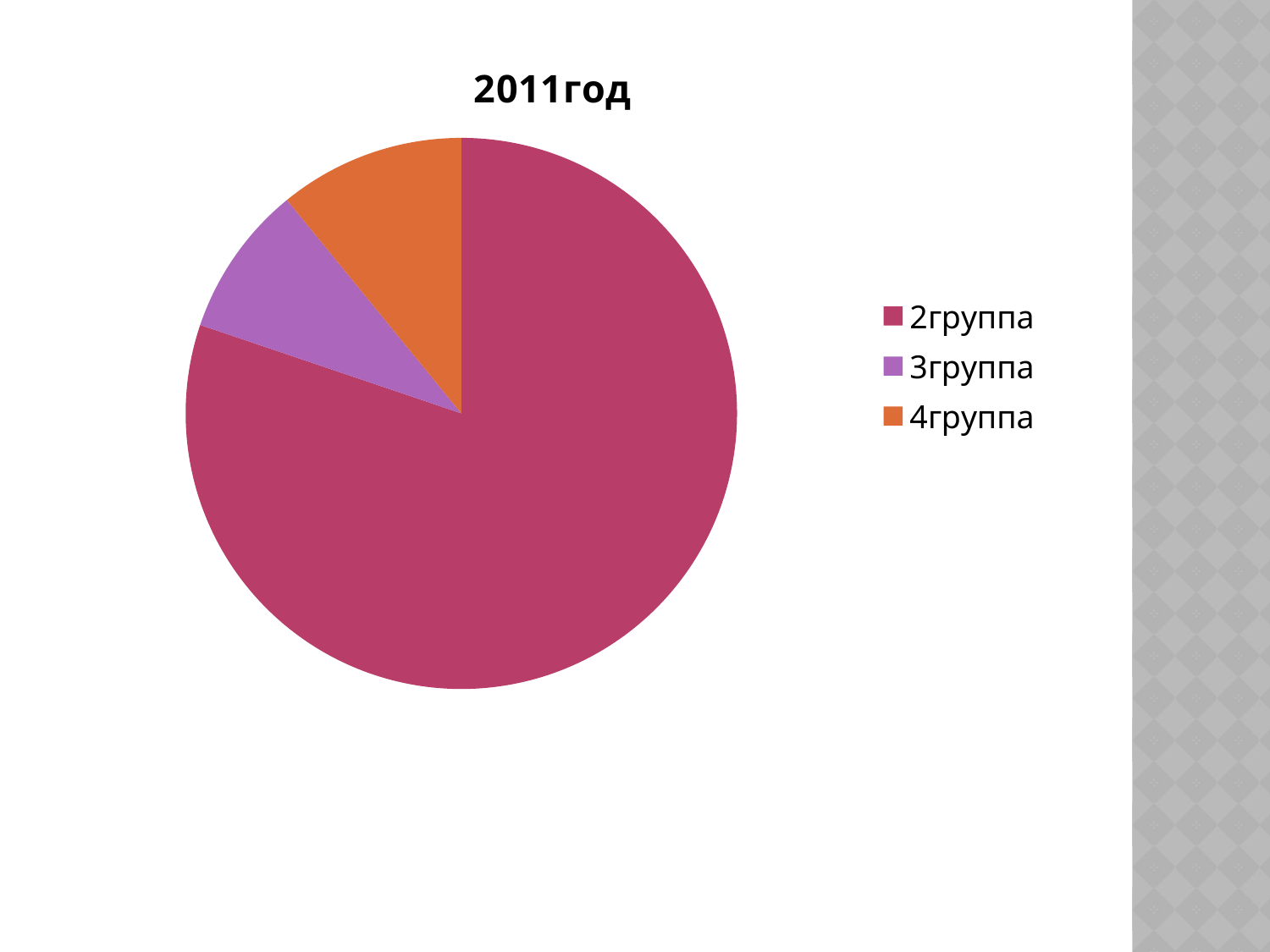
How many slices does the pie chart have? 3 Which category has the largest slice of the pie? 2группа What kind of chart is shown on the slide? pie chart Which category has the smallest slice of the pie? 3группа Which slice is larger, 2группа or 4группа? 2группа What colour is the slice for 2группа? magenta (dark pink) What is the title of the chart? 2011год How many entries does the legend list? 3 Which slice is larger, 2группа or 3группа? 2группа Does the 2группа slice take up more or less than half of the pie? more